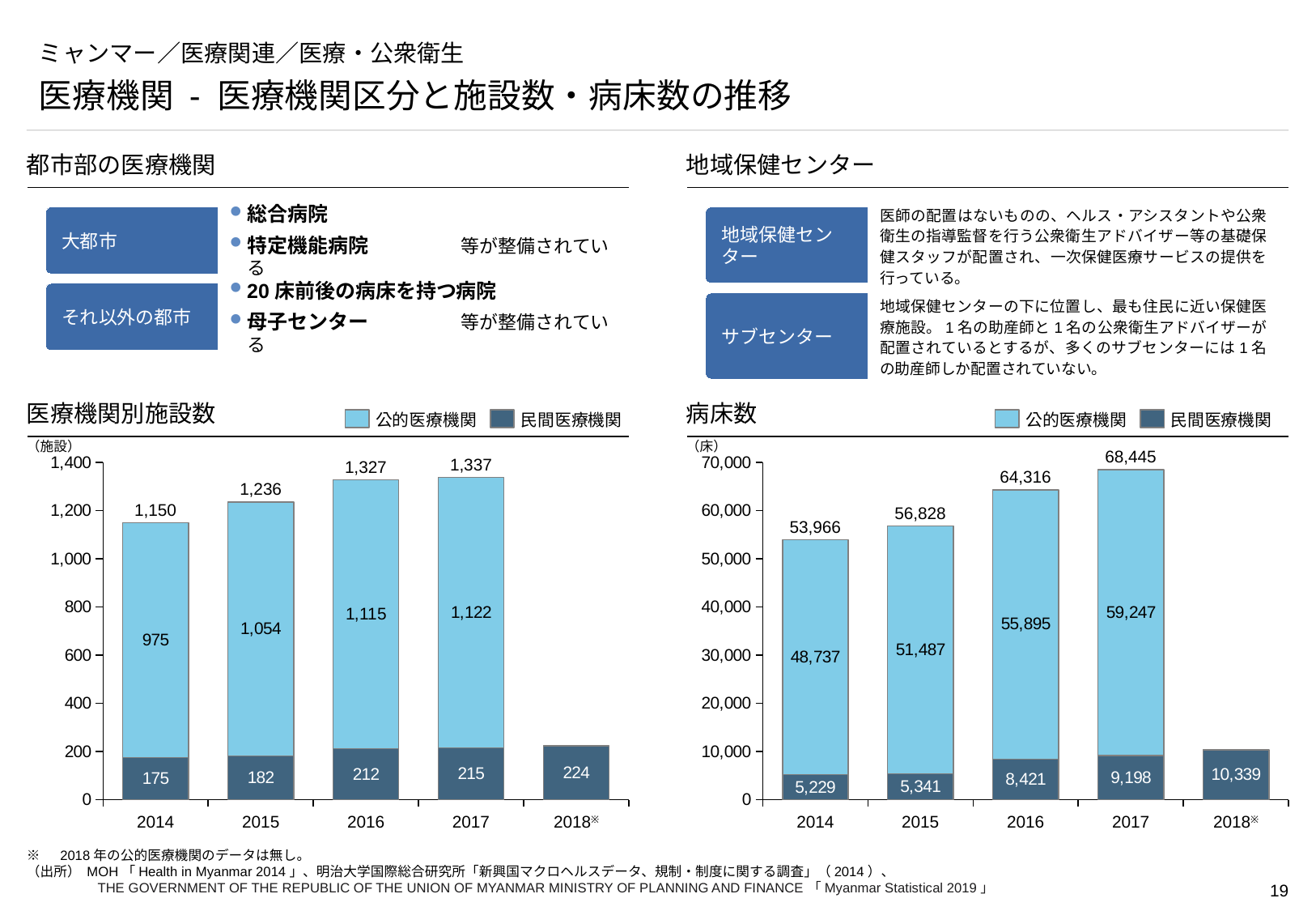
In the 医療機関別施設数 chart, what is the difference between the 公的医療機関 values for 2017 and 2014? 147 In the 病床数 chart, what is the total of the stacked bar for 2017? 68,445 In the 病床数 chart, what is the difference between the 民間医療機関 values for 2018 and 2017? 1,141 In the 医療機関別施設数 chart, what is the value for 公的医療機関 in 2016? 1,115 In the 病床数 chart, do the 公的医療機関 values rise or fall from 2014 to 2017? rise What kind of chart is the 病床数 chart? stacked bar chart In the 医療機関別施設数 chart, which year has the highest 民間医療機関 value? 2018 In the 医療機関別施設数 chart, what is the total of the stacked bar for 2015? 1,236 In the 医療機関別施設数 chart, how many series does the legend list? 2 In the 医療機関別施設数 chart, what is the value for 民間医療機関 in 2018? 224 In the 病床数 chart, what is the value for 民間医療機関 in 2016? 8,421 In the 病床数 chart, which year has the lowest 公的医療機関 value? 2014